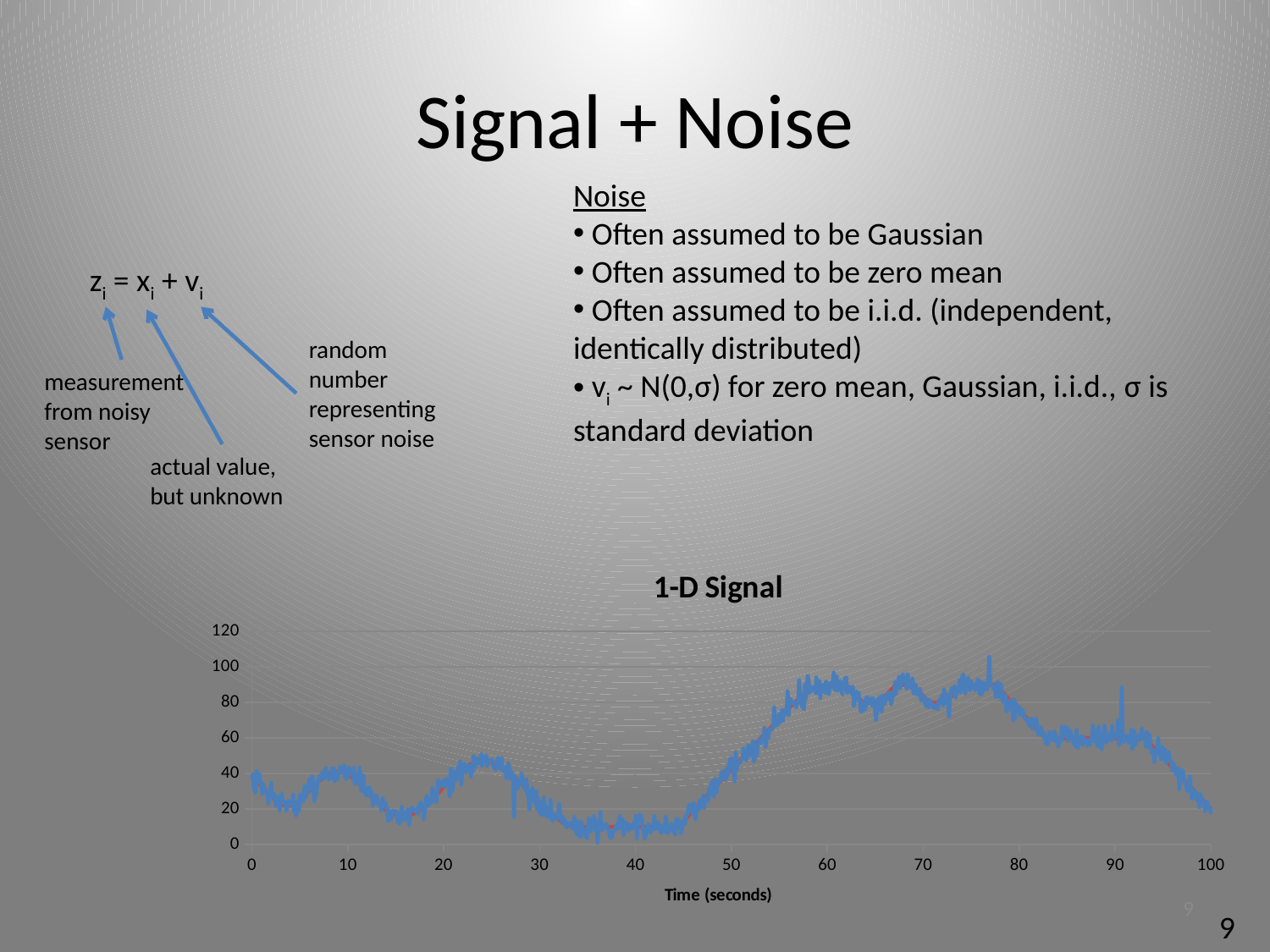
Which is larger, the signal value at time 60 or at time 35? time 60 Is the value of the signal at time 15 greater or less than 40? less Is the value of the signal at time 70 greater or less than 60? greater Is the value of the signal at time 100 greater or less than 40? less Do the signal values rise or fall between time 80 and time 100? fall Which is larger, the signal value at time 10 or at time 40? time 10 What is the title of the chart? 1-D Signal Do the signal values rise or fall between time 45 and time 58? rise What kind of chart is shown on the slide? line chart What is the label on the x axis of the chart? Time (seconds)